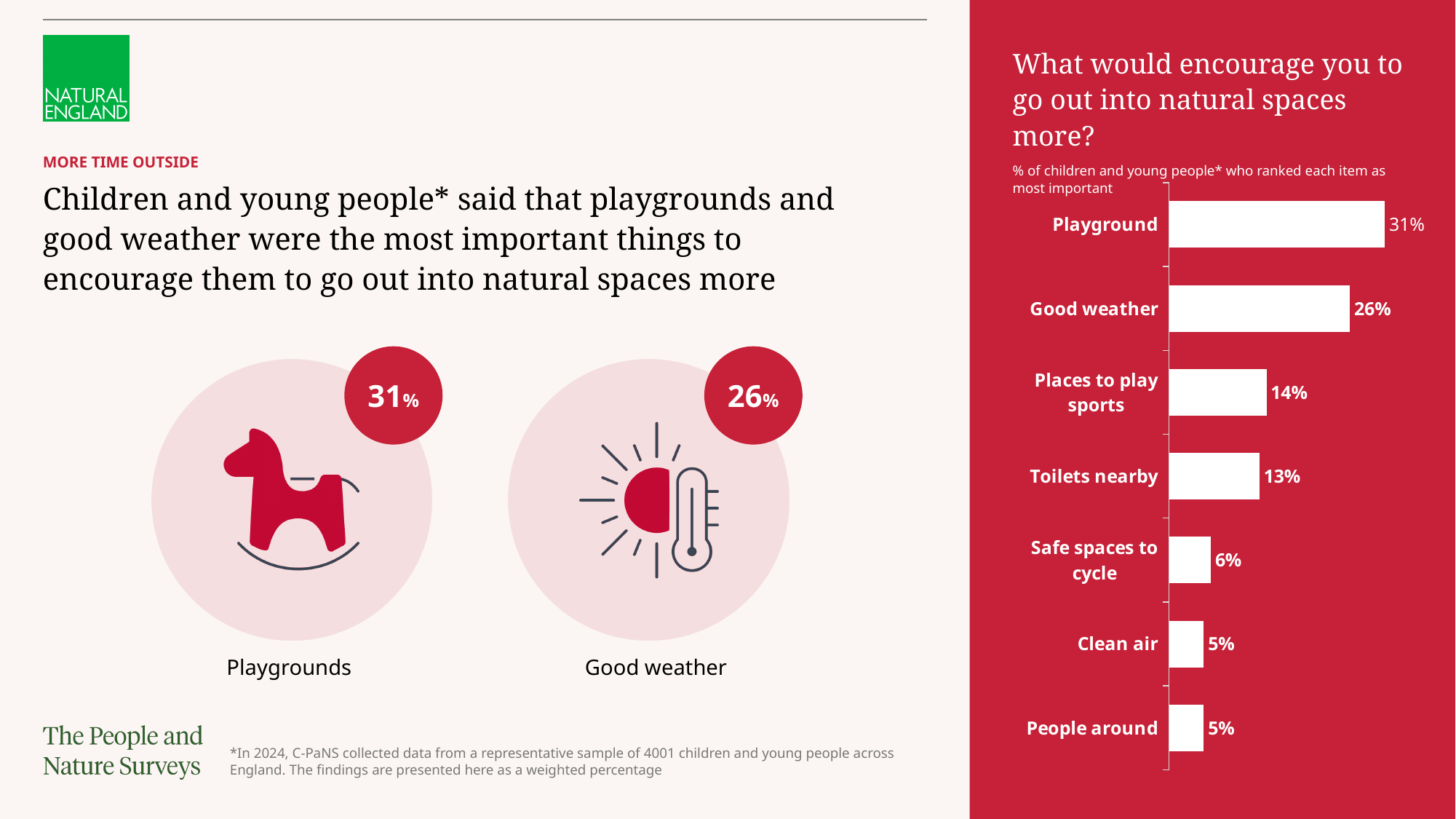
What is the value for Toilets nearby? 13% What is the title of the bar chart? What would encourage you to go out into natural spaces more? How many categories are shown in the bar chart? 7 Which category has the highest value in the bar chart? Playground Which is larger, the value for Places to play sports or the value for Toilets nearby? Places to play sports What is the value for Good weather in the bar chart? 26% What percentage is shown for Places to play sports? 14% What is the difference between the values for Playground and Good weather? 5% What is the difference between the values for Good weather and Clean air? 21% What kind of chart is shown on the slide? Bar chart What percentage is shown for Safe spaces to cycle? 6% What percentage of children and young people ranked Playground as most important? 31%